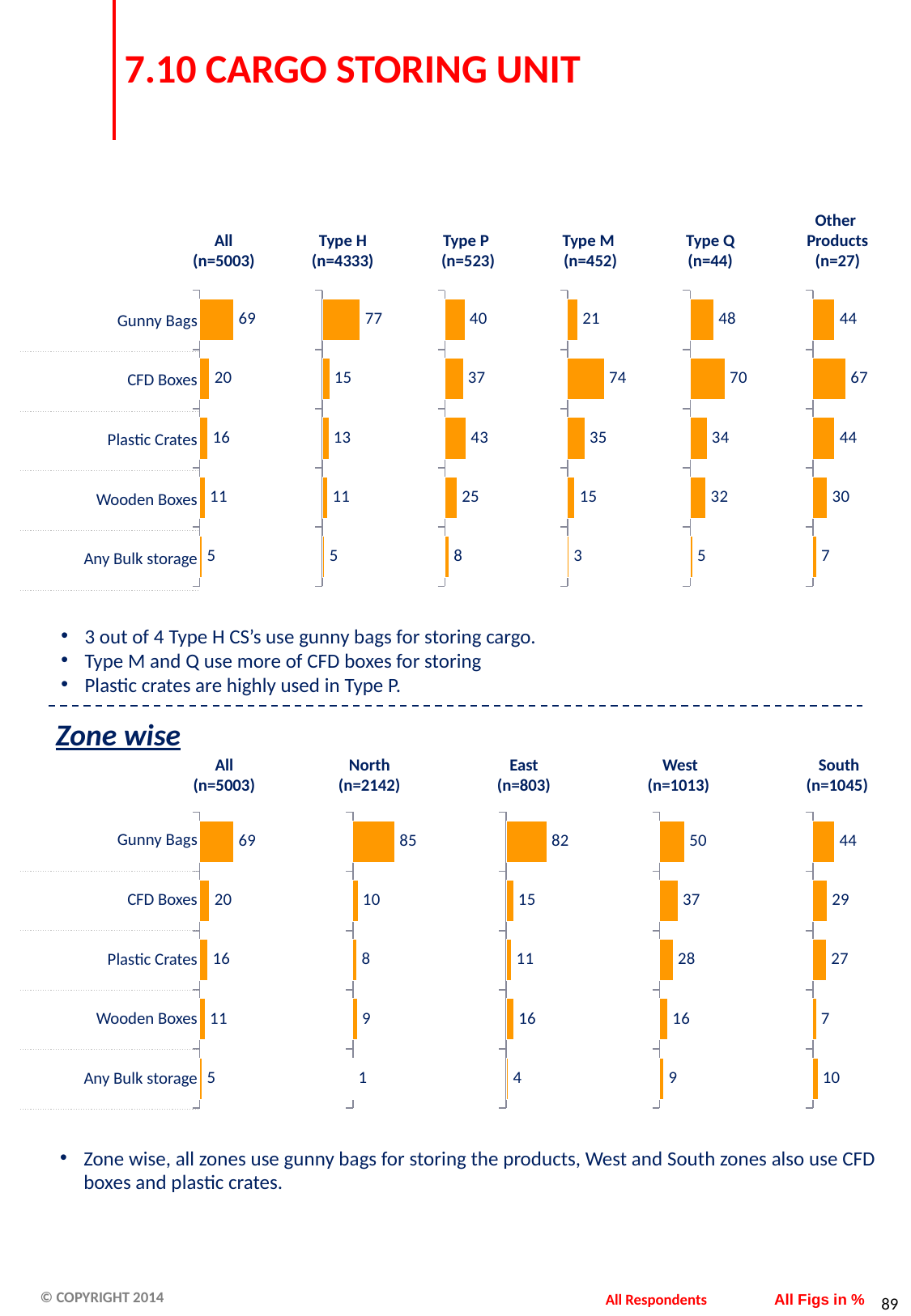
In the Zone wise set of charts, what is the value for Any Bulk storage in the South (n=1045) chart? 10 In the top set of charts (by type), what is the difference between Gunny Bags and CFD Boxes in the All (n=5003) chart? 49 In the top set of charts (by type), what is the value for CFD Boxes in the Type M (n=452) chart? 74 What type of chart is used on this slide? Bar chart In the top set of charts (by type), which is larger in the Other Products (n=27) chart: CFD Boxes or Wooden Boxes? CFD Boxes In the Zone wise set of charts, which category has the lowest value in the North (n=2142) chart? Any Bulk storage In the Zone wise set of charts, what is the difference between Gunny Bags in the East (n=803) chart and Gunny Bags in the West (n=1013) chart? 32 In the top set of charts (by type), what is the value for Gunny Bags in the Type H (n=4333) chart? 77 In the top set of charts (by type), which category has the highest value in the Type P (n=523) chart? Plastic Crates In the Zone wise set of charts, what is the value for Gunny Bags in the North (n=2142) chart? 85 In the top set of charts (by type), which category has the lowest value in the Type Q (n=44) chart? Any Bulk storage How many storage categories are shown in each chart on the slide? 5